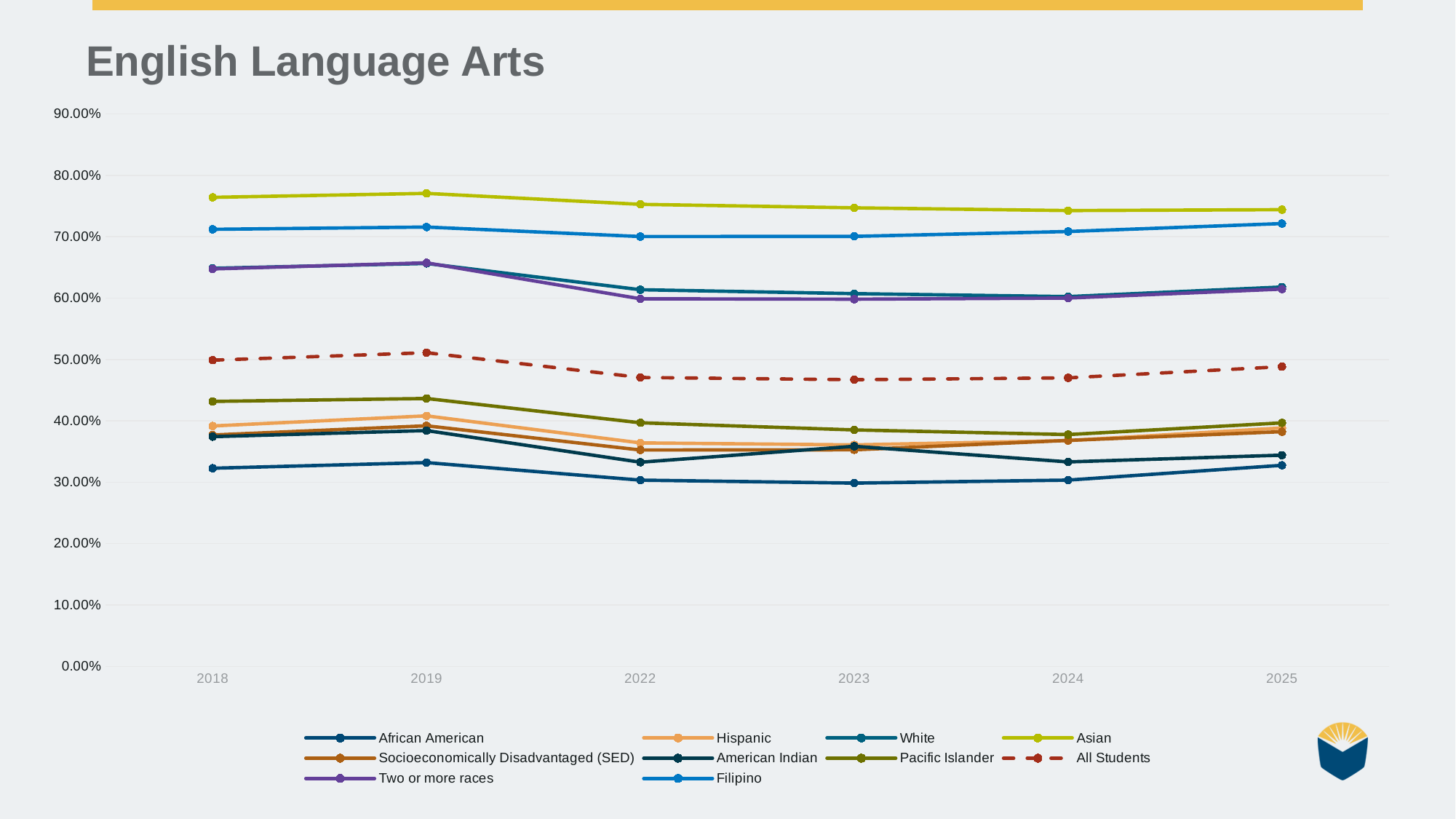
Which series has the highest value in 2018? Asian How many years are shown along the x axis? 6 In 2024, which is larger: Filipino or All Students? Filipino Is the value for Pacific Islander in 2018 greater or less than 50%? less Does the All Students line rise or fall from 2019 to 2022? fall Which series has the lowest value in 2025? African American In 2022, which is larger: Asian or Filipino? Asian Which series is drawn with a dashed line? All Students Is the value for Asian in 2019 greater or less than 70%? greater How many series does the legend list? 10 Is the value for African American in 2023 greater or less than 40%? less What kind of chart is shown on the slide? line chart